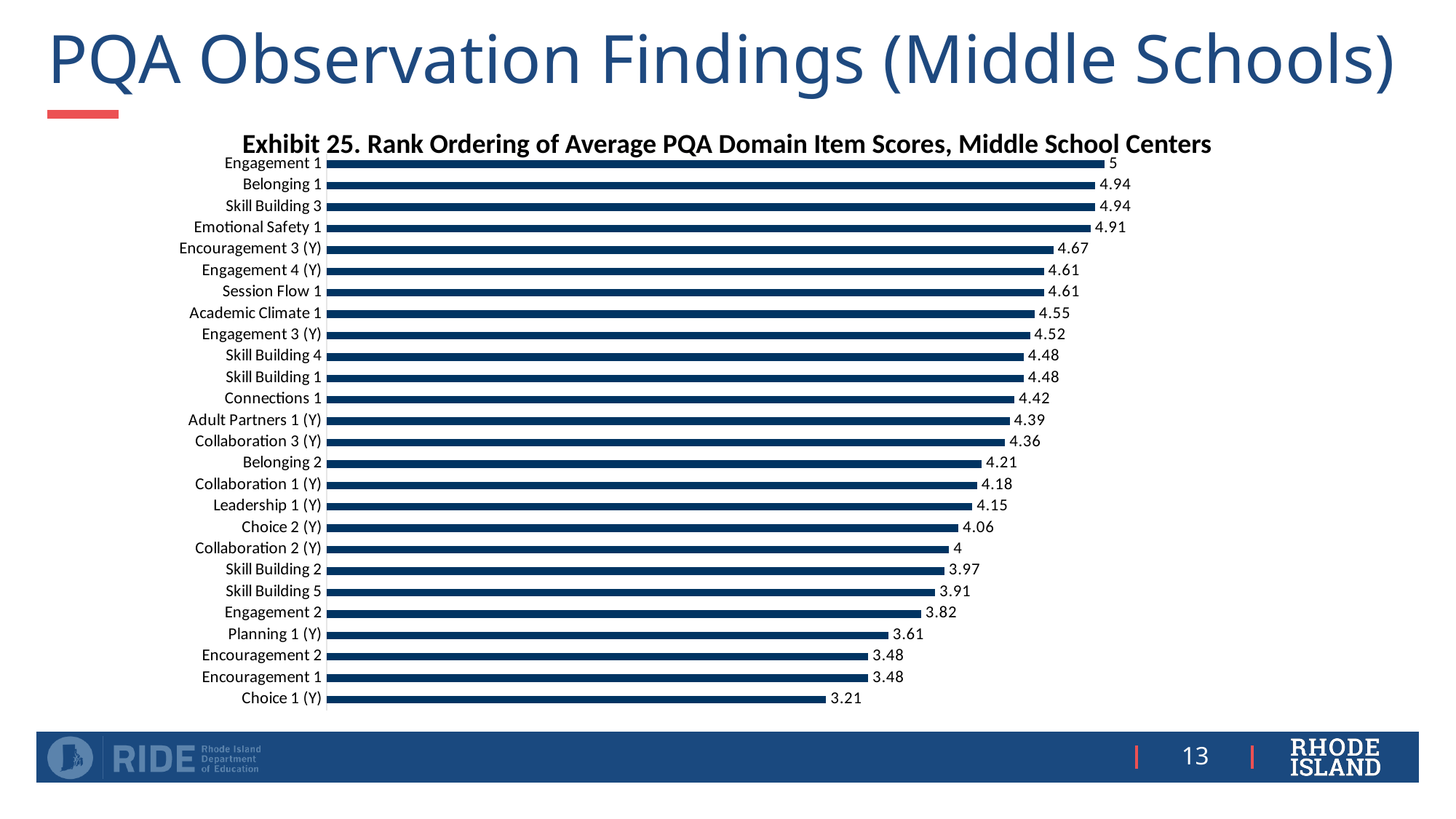
What is the average score for Planning 1 (Y)? 3.61 What is the difference between the scores for Encouragement 3 (Y) and Collaboration 2 (Y)? 0.67 Which has a higher average score, Academic Climate 1 or Leadership 1 (Y)? Academic Climate 1 Which has a higher average score, Belonging 2 or Skill Building 2? Belonging 2 Which item has the highest average score? Engagement 1 Which item has the lowest average score? Choice 1 (Y) What is the average score for Connections 1? 4.42 What is the difference between the scores for Engagement 1 and Choice 1 (Y)? 1.79 What is the title of the chart? Exhibit 25. Rank Ordering of Average PQA Domain Item Scores, Middle School Centers What kind of chart is shown on the slide? Bar chart How many items are shown in the chart? 26 What is the average score for Emotional Safety 1? 4.91